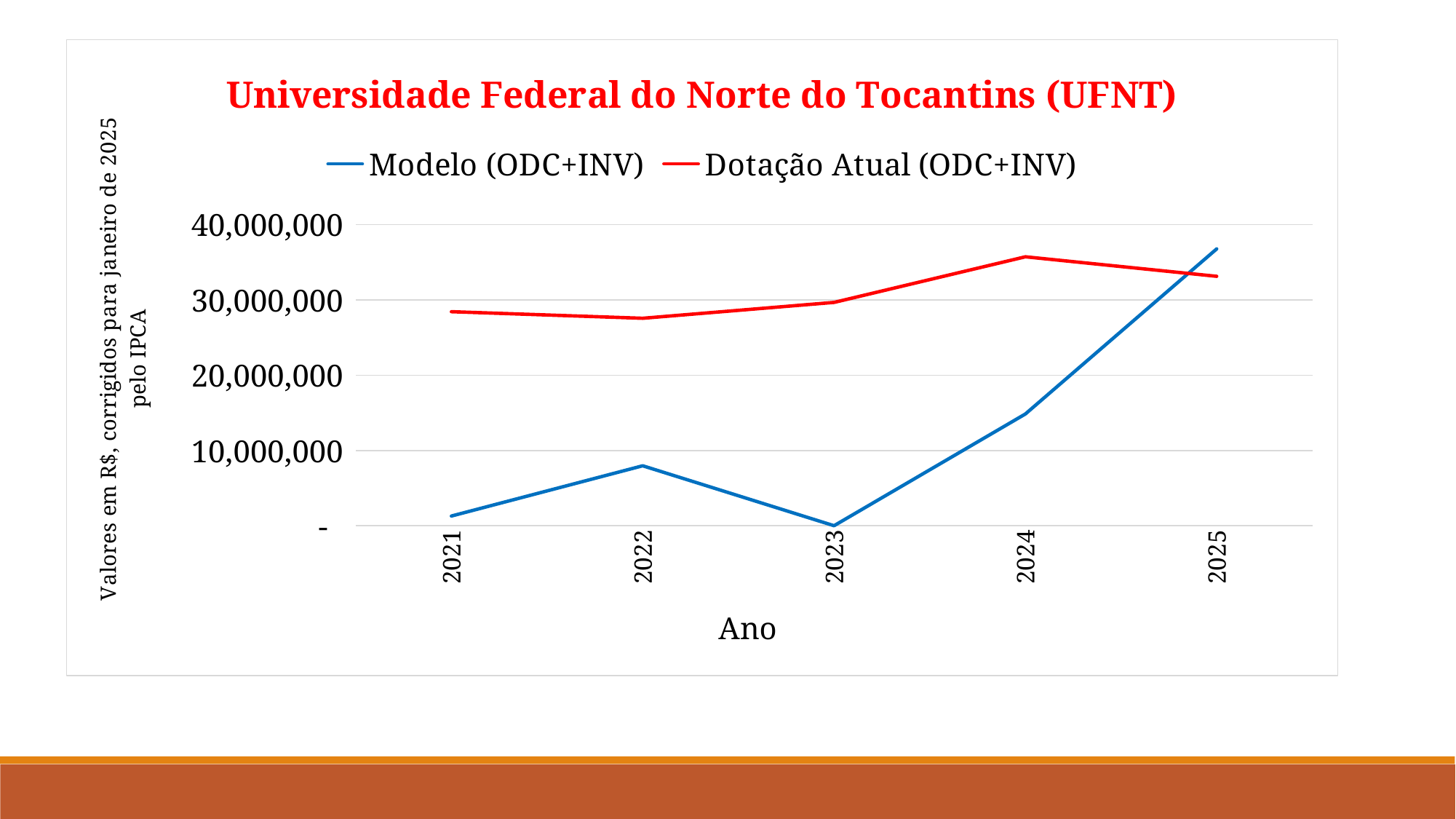
What kind of chart is shown on the slide? line chart In 2024, which series has the larger value, Modelo (ODC+INV) or Dotação Atual (ODC+INV)? Dotação Atual (ODC+INV) Is the value for Modelo (ODC+INV) in 2022 greater or less than 10,000,000? less In which year does the Dotação Atual (ODC+INV) series reach its highest value? 2024 Is the value for Modelo (ODC+INV) in 2024 greater or less than 20,000,000? less In 2025, which series has the larger value, Modelo (ODC+INV) or Dotação Atual (ODC+INV)? Modelo (ODC+INV) Is the value for Dotação Atual (ODC+INV) in 2021 greater or less than 20,000,000? greater Does the Modelo (ODC+INV) series rise or fall from 2023 to 2025? rise How many series does the legend list? 2 In which year does the Modelo (ODC+INV) series reach its lowest value? 2023 How many years are plotted along the x axis? 5 In which year does the Modelo (ODC+INV) series reach its highest value? 2025